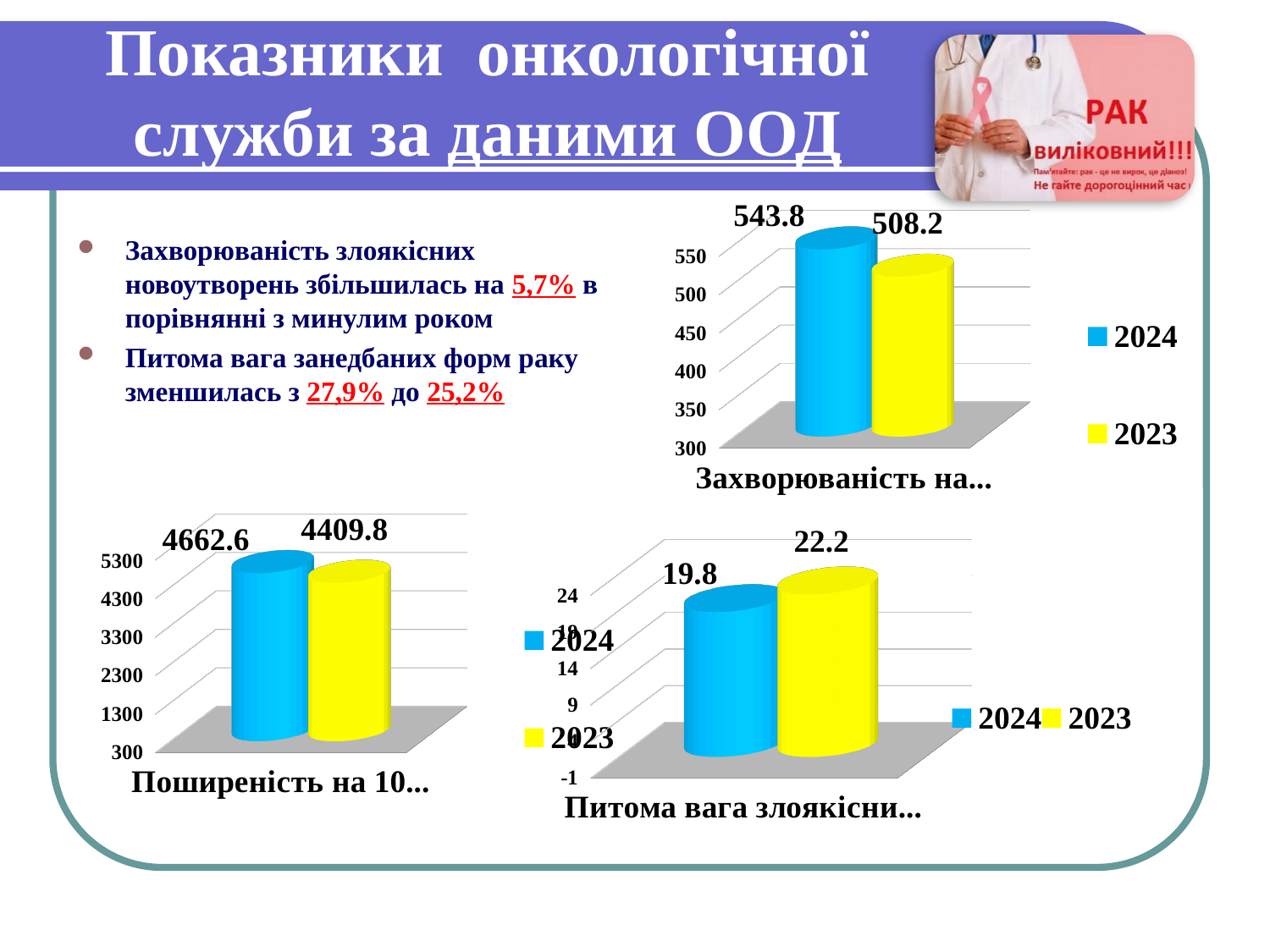
In the top-right chart (Захворюваність на...), what is the value for 2024? 543.8 In the top-right chart (Захворюваність на...), what is the value for 2023? 508.2 In the bottom-left chart (Поширеність на 10...), which year has the higher value? 2024 What type of chart is the bottom-left chart (Поширеність на 10...)? bar chart In the top-right chart (Захворюваність на...), what is the difference between the 2024 and 2023 values? 35.6 In the bottom-right chart (Питома вага злоякісни...), what is the value for 2023? 22.2 In the bottom-right chart (Питома вага злоякісни...), which year has the lower value? 2024 In the bottom-right chart (Питома вага злоякісни...), what is the difference between the 2023 and 2024 values? 2.4 In the bottom-left chart (Поширеність на 10...), what is the value for 2024? 4662.6 How many series does the legend of the top-right chart (Захворюваність на...) list? 2 In the bottom-right chart (Питома вага злоякісни...), what is the value for 2024? 19.8 In the bottom-left chart (Поширеність на 10...), what is the value for 2023? 4409.8